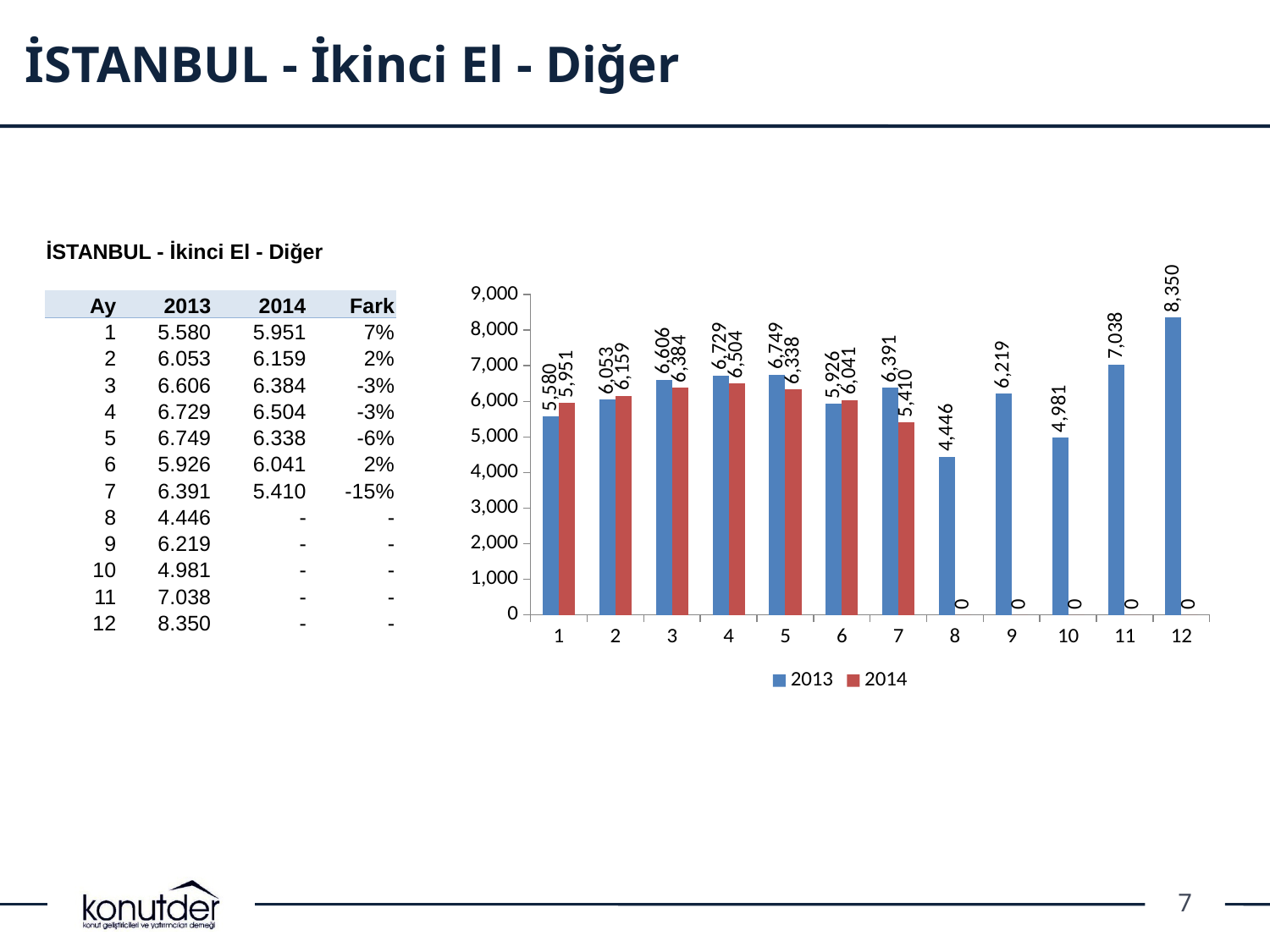
Which is larger for month 5, the 2013 value or the 2014 value? 2013 Which month has the lowest 2013 value? 8 Which month has the lowest 2014 value among months 1 to 7? 7 Is the 2013 value for month 11 greater or less than 6,000? greater What is the 2013 value for month 8? 4,446 Which month has the highest 2013 value? 12 How many months are shown on the x axis? 12 What kind of chart is shown? bar chart How many series does the legend list? 2 What is the 2013 value for month 12? 8,350 What is the difference between the 2013 and 2014 values for month 1? 371 What is the 2014 value for month 7? 5,410